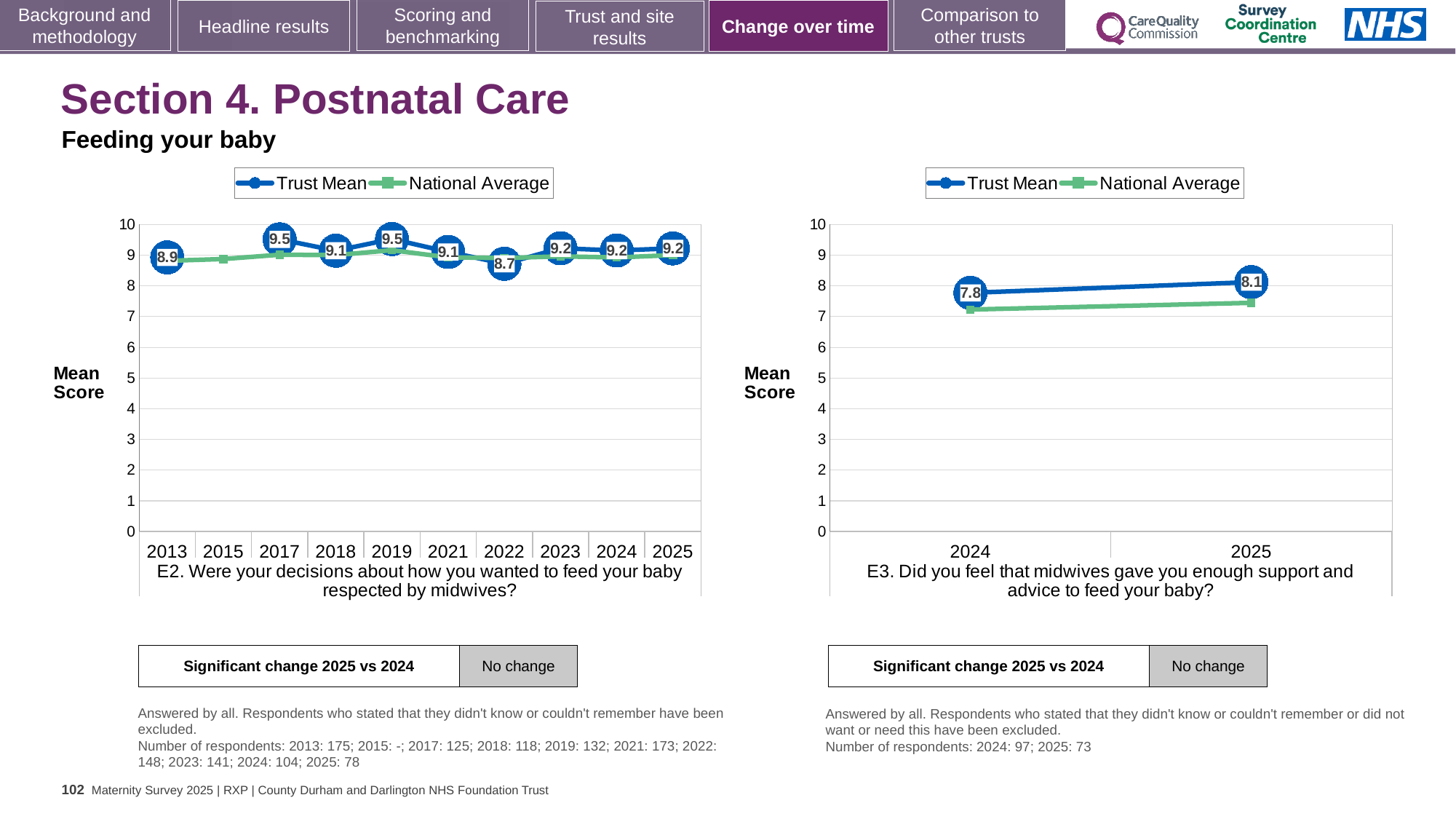
In the E2 chart (left), which year has the lowest Trust Mean? 2022 In the E2 chart (left), what is the Trust Mean for 2025? 9.2 In the E2 chart (left), is the Trust Mean for 2013 greater or less than 8? greater What kind of chart is the E3 chart (right)? line chart In the E3 chart (right), does the Trust Mean rise or fall from 2024 to 2025? rise In the E2 chart (left), how many years are shown on the x axis? 10 In the E3 chart (right), what is the Trust Mean for 2024? 7.8 In the E3 chart (right), what is the Trust Mean for 2025? 8.1 In the E2 chart (left), what is the difference between the Trust Mean in 2017 and in 2022? 0.8 In the E3 chart (right), how many series does the legend list? 2 In the E3 chart (right), what is the difference between the Trust Mean in 2025 and in 2024? 0.3 In the E2 chart (left), what is the Trust Mean for 2022? 8.7